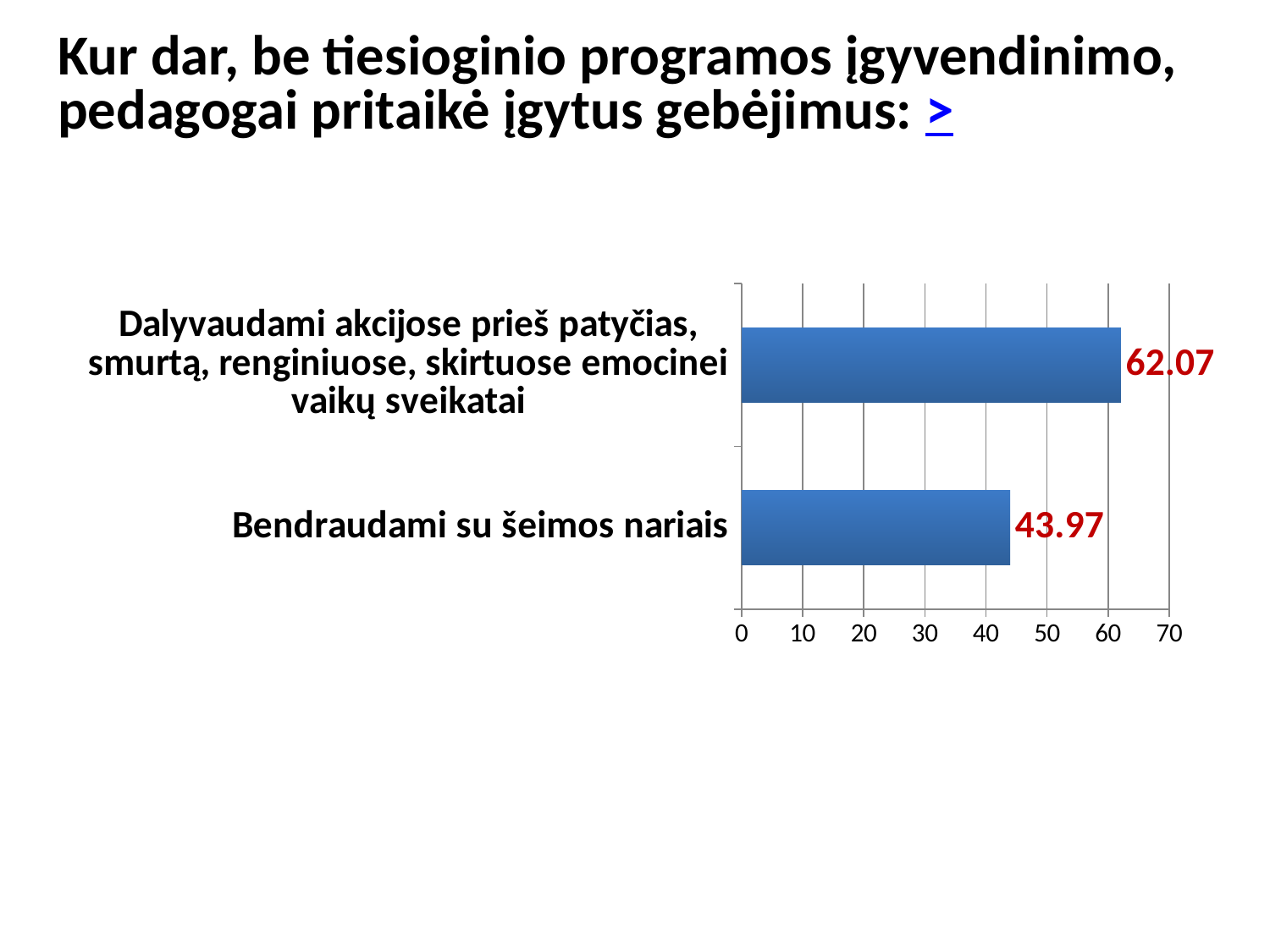
Is the value for "Dalyvaudami akcijose prieš patyčias, smurtą, renginiuose, skirtuose emocinei vaikų sveikatai" greater or less than 60? greater What kind of chart is shown on the slide? bar chart How many categories are shown in the chart? 2 What is the maximum value shown on the horizontal axis? 70 Which is larger: the value for "Bendraudami su šeimos nariais" or the value for "Dalyvaudami akcijose prieš patyčias, smurtą, renginiuose, skirtuose emocinei vaikų sveikatai"? Dalyvaudami akcijose prieš patyčias, smurtą, renginiuose, skirtuose emocinei vaikų sveikatai What is the value for "Dalyvaudami akcijose prieš patyčias, smurtą, renginiuose, skirtuose emocinei vaikų sveikatai"? 62.07 Which category has the lowest value? Bendraudami su šeimos nariais What is the difference between the values for "Dalyvaudami akcijose prieš patyčias, smurtą, renginiuose, skirtuose emocinei vaikų sveikatai" and "Bendraudami su šeimos nariais"? 18.1 Which category has the highest value? Dalyvaudami akcijose prieš patyčias, smurtą, renginiuose, skirtuose emocinei vaikų sveikatai What is the value for "Bendraudami su šeimos nariais"? 43.97 Is the value for "Bendraudami su šeimos nariais" greater or less than 50? less What colour are the bars in the chart? blue